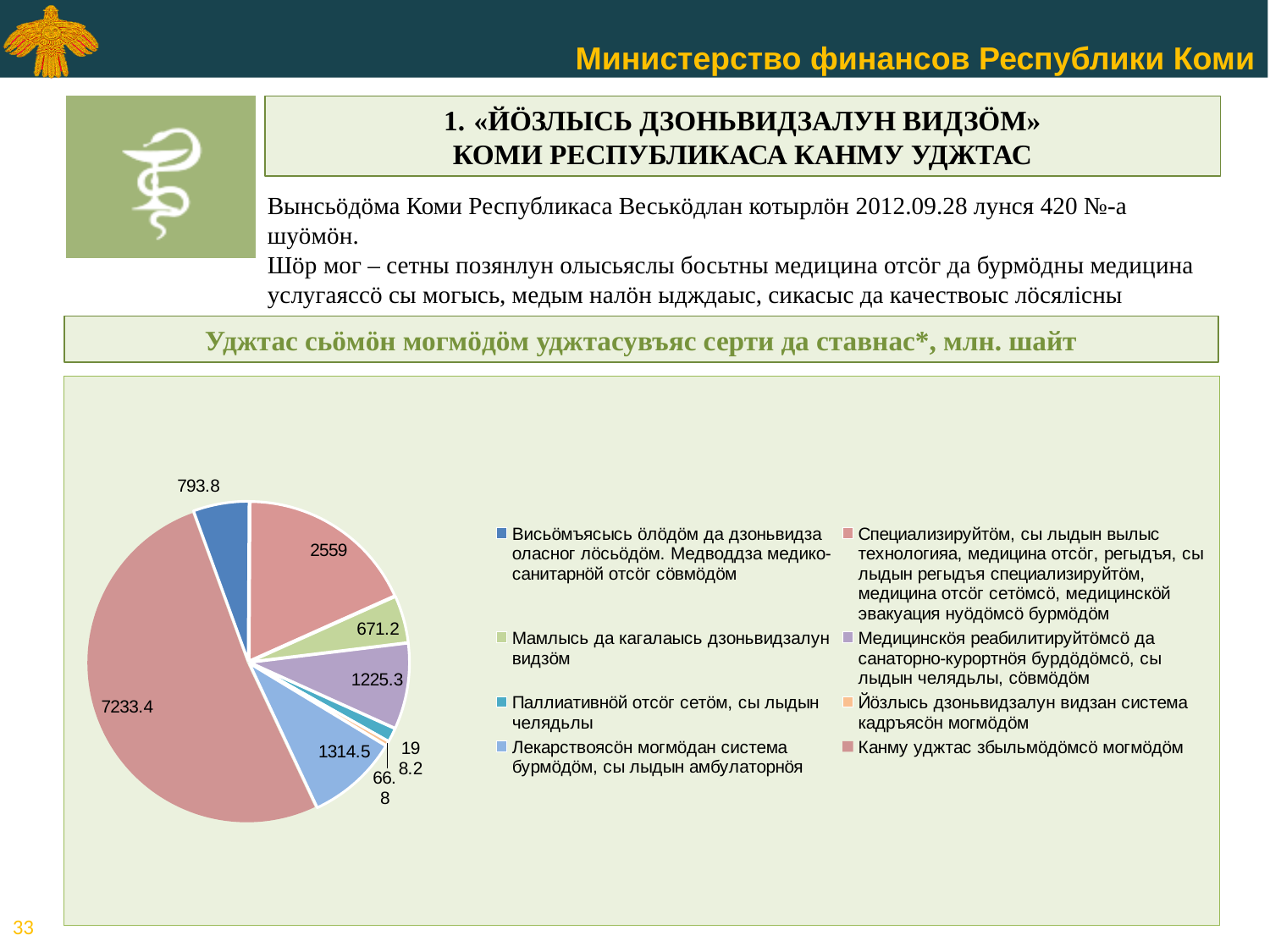
What is the value of the slice for «Медицинскöя реабилитируйтöмсö да санаторно-курортнöя бурдöдöмсö, сы лыдын челядьлы, сöвмöдöм»? 1225.3 What is the value of the slice for «Лекарствоясöн могмöдан система бурмöдöм, сы лыдын амбулаторнöя»? 1314.5 Which category has the largest slice in the pie chart? Канму уджтас збыльмöдöмсö могмöдöм Which is larger: the slice for «Лекарствоясöн могмöдан система бурмöдöм, сы лыдын амбулаторнöя» or the slice for «Висьöмъясысь öлöдöм да дзоньвидза оласног лöсьöдöм. Медводдза медико-санитарнöй отсöг сöвмöдöм»? Лекарствоясöн могмöдан система бурмöдöм, сы лыдын амбулаторнöя What is the smallest value labelled on the pie chart? 66.8 What kind of chart is shown on the slide? pie chart What is the value of the slice for «Мамлысь да кагалаысь дзоньвидзалун видзöм»? 671.2 In what units are the values of the chart given, according to the chart title? млн. шайт What is the value of the slice for «Канму уджтас збыльмöдöмсö могмöдöм»? 7233.4 How many entries does the legend of the pie chart list? 8 What is the difference between the slice labelled 2559 and the slice labelled 1225.3? 1333.7 What is the value of the slice for «Висьöмъясысь öлöдöм да дзоньвидза оласног лöсьöдöм. Медводдза медико-санитарнöй отсöг сöвмöдöм»? 793.8